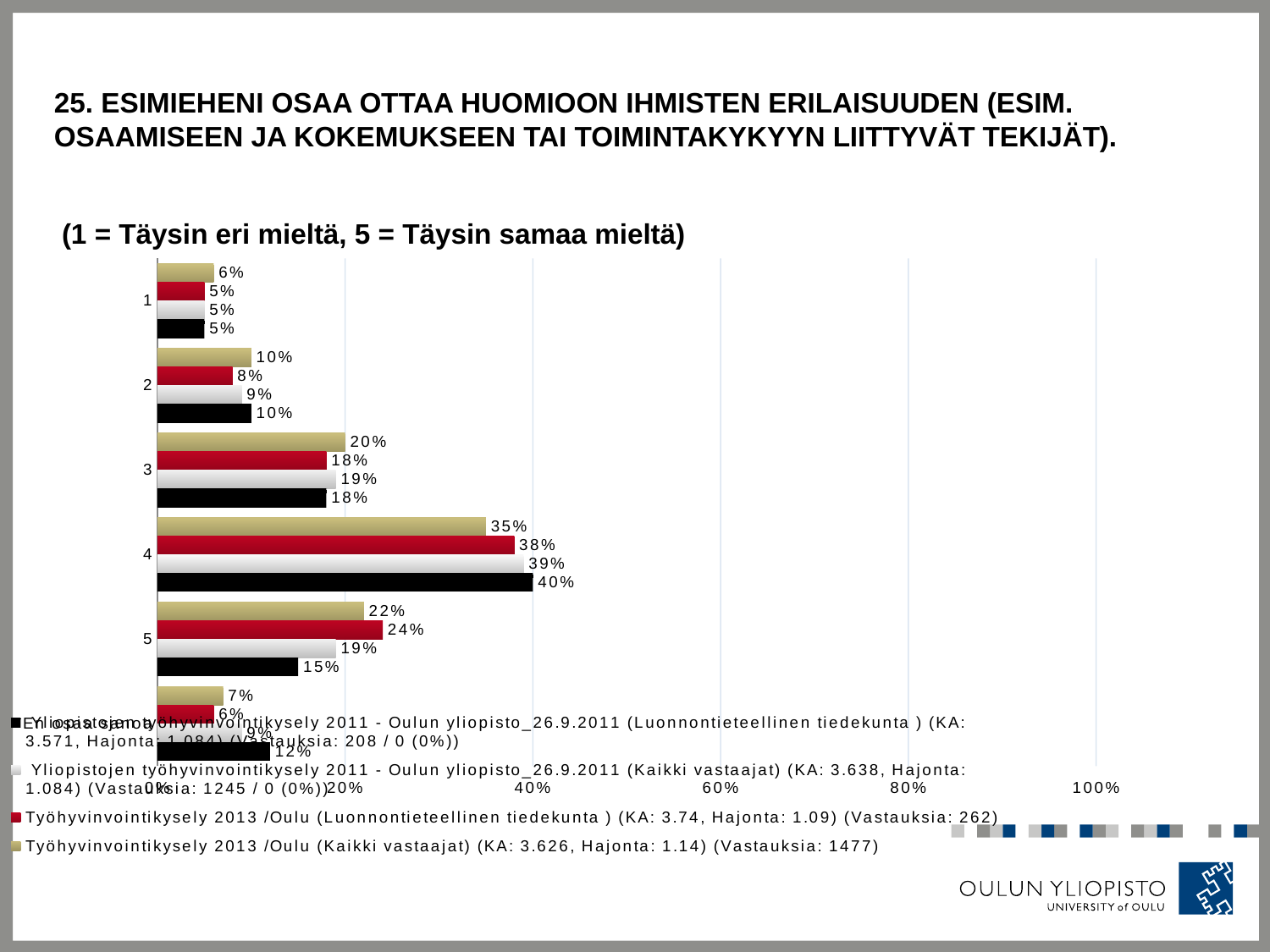
Is the value for category 4 in the series Yliopistojen työhyvinvointikysely 2011 - Oulun yliopisto (Kaikki vastaajat) greater or less than 20%? greater What is the KA (mean) given in the legend for Työhyvinvointikysely 2013 /Oulu (Luonnontieteellinen tiedekunta)? 3.74 What is the value for category 4 in the series Yliopistojen työhyvinvointikysely 2011 - Oulun yliopisto (Luonnontieteellinen tiedekunta)? 40% Which category (1 to 5) has the lowest value in the series Työhyvinvointikysely 2013 /Oulu (Luonnontieteellinen tiedekunta)? 1 What type of chart is shown on the slide? bar chart What is the value for category 4 in the series Työhyvinvointikysely 2013 /Oulu (Kaikki vastaajat)? 35% How many series does the legend list? 4 What is the value for category 5 in the series Työhyvinvointikysely 2013 /Oulu (Luonnontieteellinen tiedekunta)? 24% Which category (1 to 5) has the highest value in the series Työhyvinvointikysely 2013 /Oulu (Kaikki vastaajat)? 4 What is the value for category 3 in the series Yliopistojen työhyvinvointikysely 2011 - Oulun yliopisto (Kaikki vastaajat)? 19% For category 4, which series has the larger value: Työhyvinvointikysely 2013 /Oulu (Kaikki vastaajat) or Yliopistojen työhyvinvointikysely 2011 - Oulun yliopisto (Luonnontieteellinen tiedekunta)? Yliopistojen työhyvinvointikysely 2011 - Oulun yliopisto (Luonnontieteellinen tiedekunta) What is the difference between the values for category 5 in the series Työhyvinvointikysely 2013 /Oulu (Luonnontieteellinen tiedekunta) (24%) and Yliopistojen työhyvinvointikysely 2011 - Oulun yliopisto (Luonnontieteellinen tiedekunta) (15%)? 9%